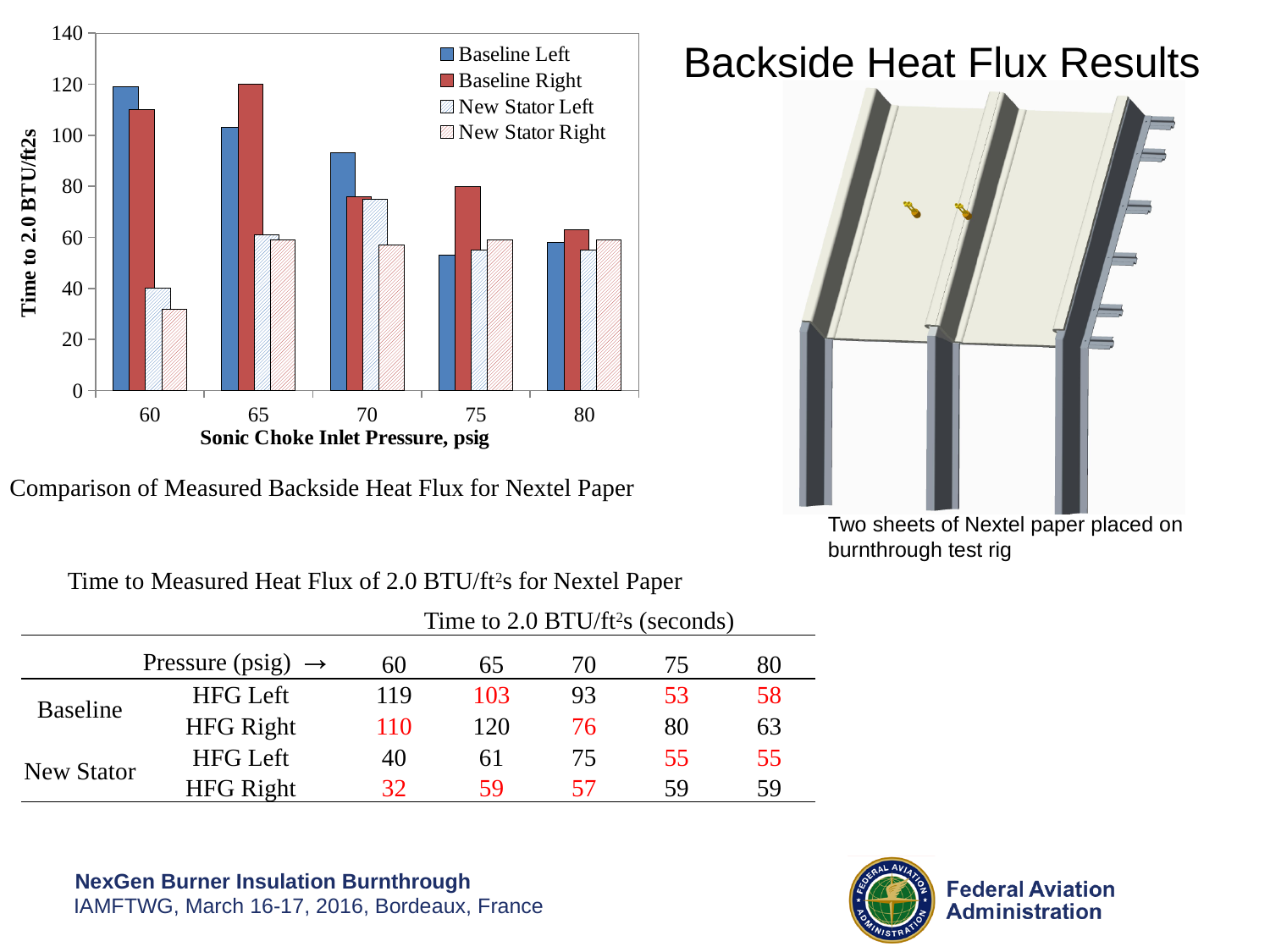
Which series has the shortest bar at 60 psig? New Stator Right What is the Baseline Left time to 2.0 BTU/ft2s at 60 psig? 119 At which pressure is the Baseline Left bar the tallest? 60 What kind of chart is shown on the left of the slide? bar chart How many series does the chart legend list? 4 What is the title of the chart's x axis? Sonic Choke Inlet Pressure, psig Is the New Stator Left value at 60 psig greater or less than 60? less Does the Baseline Left series rise or fall as pressure increases from 60 to 75 psig? fall Is the Baseline Right value at 65 psig greater or less than 100? greater At 75 psig, how much larger is the Baseline Right value than the Baseline Left value? 27 At 70 psig, which is larger: Baseline Left or Baseline Right? Baseline Left How many pressure categories are plotted along the x axis of the chart? 5